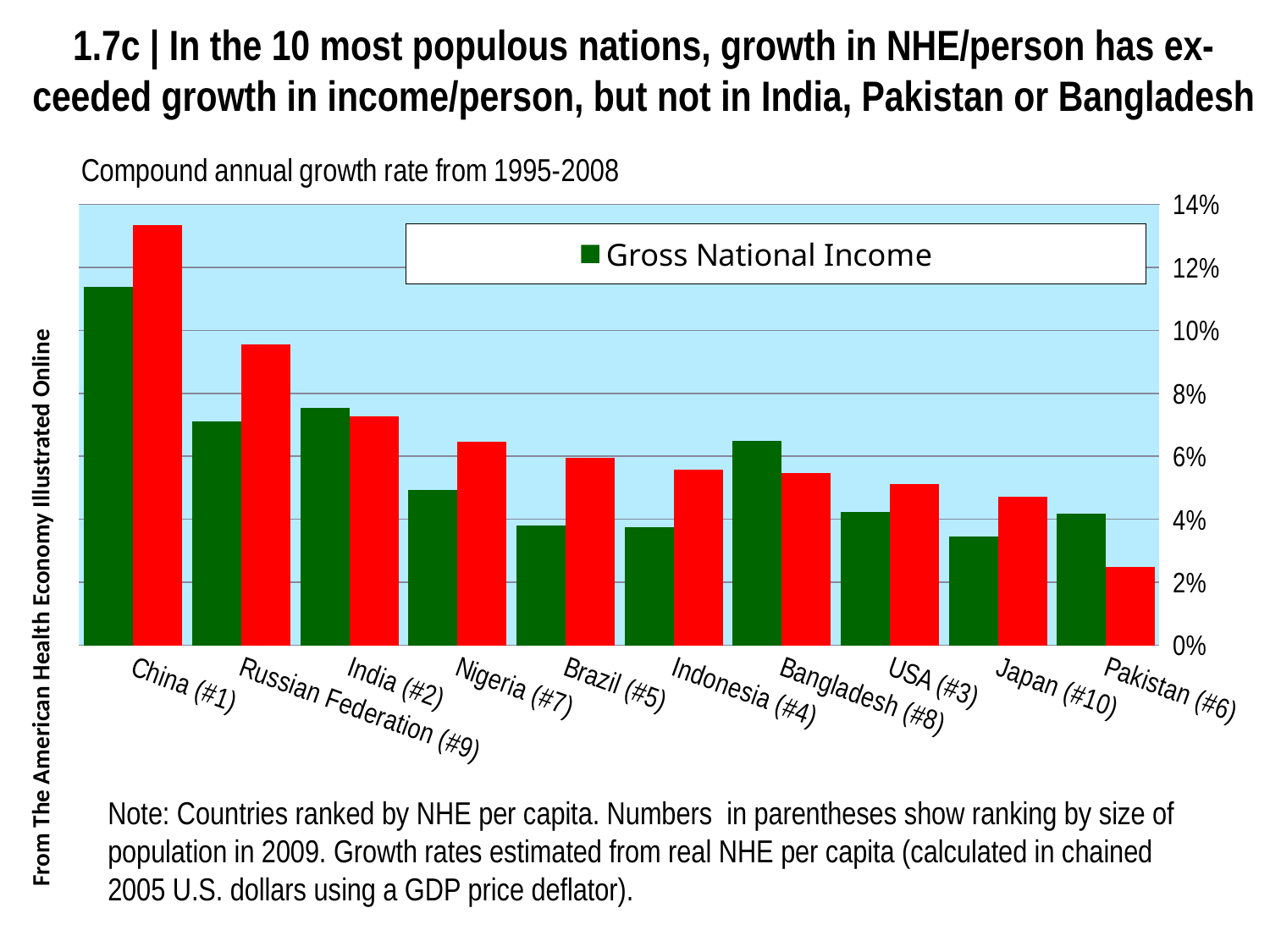
Do the red bars generally rise or fall moving from left to right across the countries? fall Which country has the highest Gross National Income growth rate in the chart? China (#1) Is the Gross National Income growth rate for China (#1) greater or less than 10%? greater Which country has the lowest value for the red bars in the chart? Pakistan (#6) Is the Gross National Income growth rate for Nigeria (#7) greater or less than 6%? less How many series does the chart's legend list? 1 Is the red bar for Pakistan (#6) greater or less than 4%? less What colour are the Gross National Income bars in the chart? green Which is larger for Bangladesh (#8): the green Gross National Income bar or the red bar? the green Gross National Income bar How many countries are shown on the x axis of the chart? 10 What kind of chart is shown on the slide? bar chart